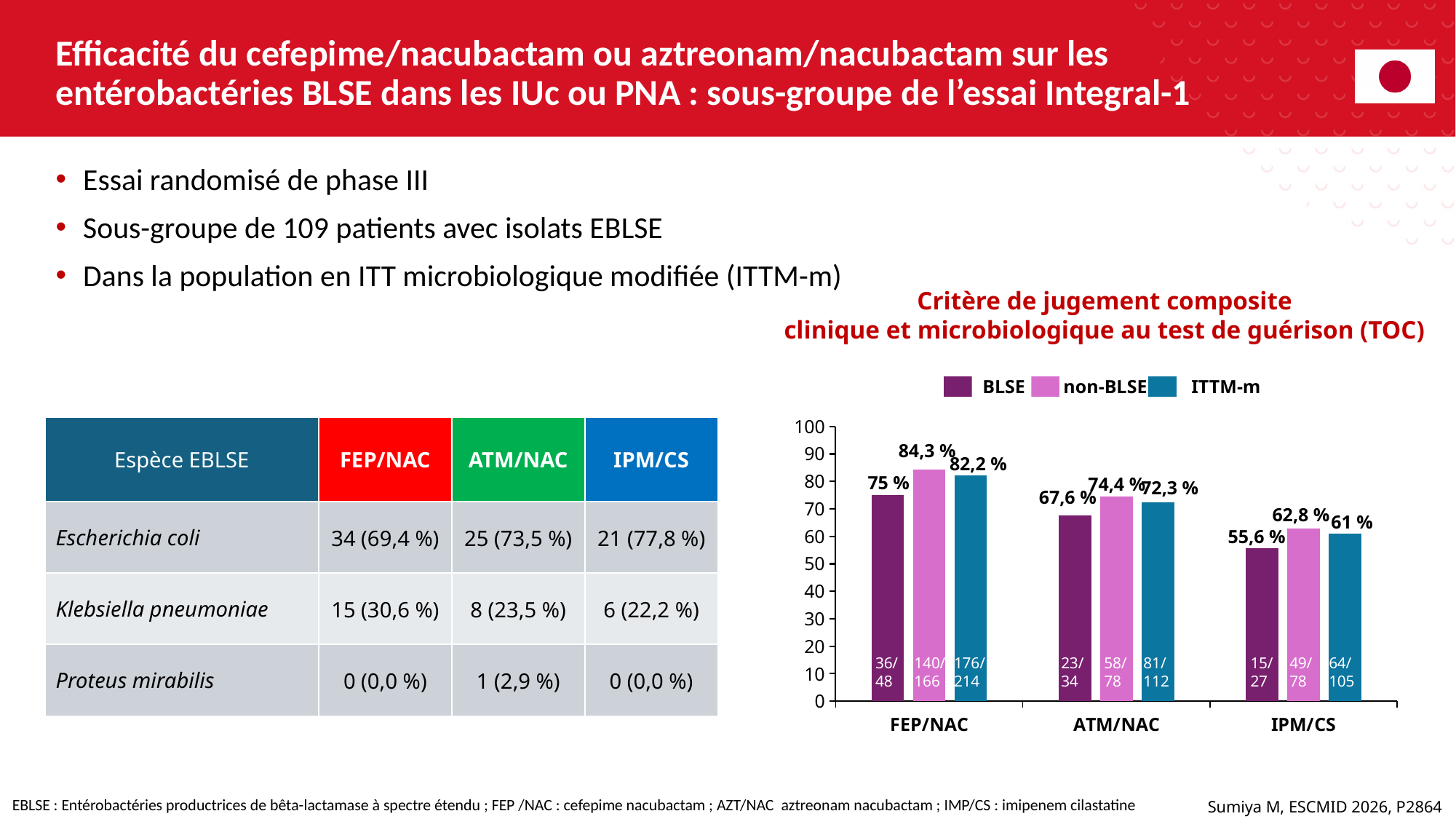
Do the BLSE values rise or fall from FEP/NAC to IPM/CS along the x axis? fall What is the value for ITTM-m in the IPM/CS group? 61 % What is the value for non-BLSE in the ATM/NAC group? 74,4 % Is the BLSE value for IPM/CS greater or less than 60? less How many treatment groups are shown on the x axis? 3 What is the value for BLSE in the FEP/NAC group? 75 % What is the difference between the non-BLSE and BLSE values in the IPM/CS group? 7,2 % What kind of chart is shown on the slide? bar chart Which treatment group has the highest non-BLSE value? FEP/NAC Which treatment group has the lowest BLSE value? IPM/CS Which is larger in the ATM/NAC group: the BLSE value or the ITTM-m value? ITTM-m How many series does the legend list? 3